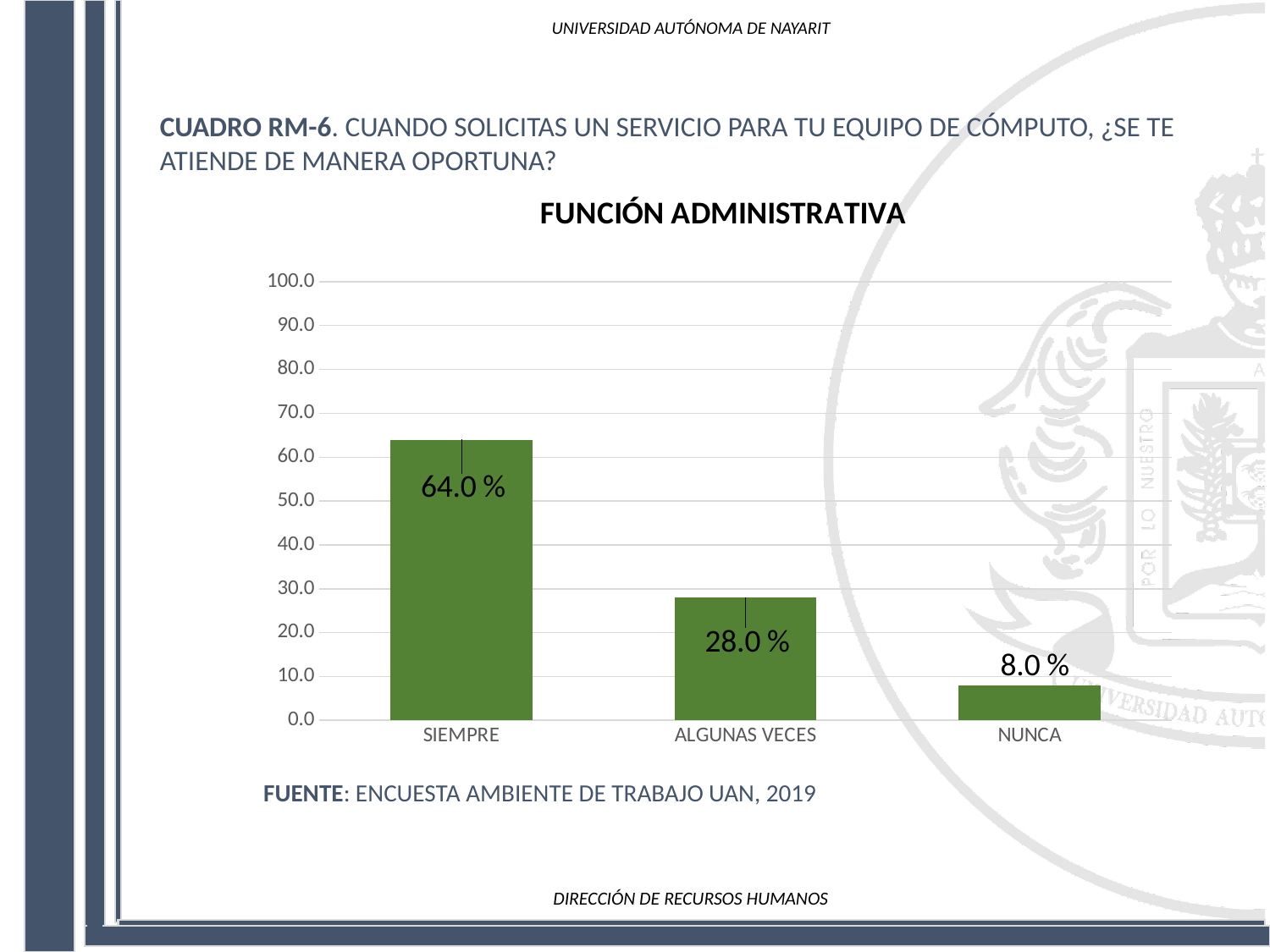
What is the difference between the values for ALGUNAS VECES and NUNCA? 20.0 % What kind of chart is shown on the slide? bar chart How many categories are shown on the x axis? 3 What is the title of the chart? FUNCIÓN ADMINISTRATIVA Which category has the lowest value? NUNCA Is the value for SIEMPRE greater or less than 60.0? greater What is the value for SIEMPRE? 64.0 % What is the value for NUNCA? 8.0 % Which category has the highest value? SIEMPRE Which is larger, the value for ALGUNAS VECES or the value for NUNCA? ALGUNAS VECES What is the difference between the values for SIEMPRE and ALGUNAS VECES? 36.0 % What is the value for ALGUNAS VECES? 28.0 %